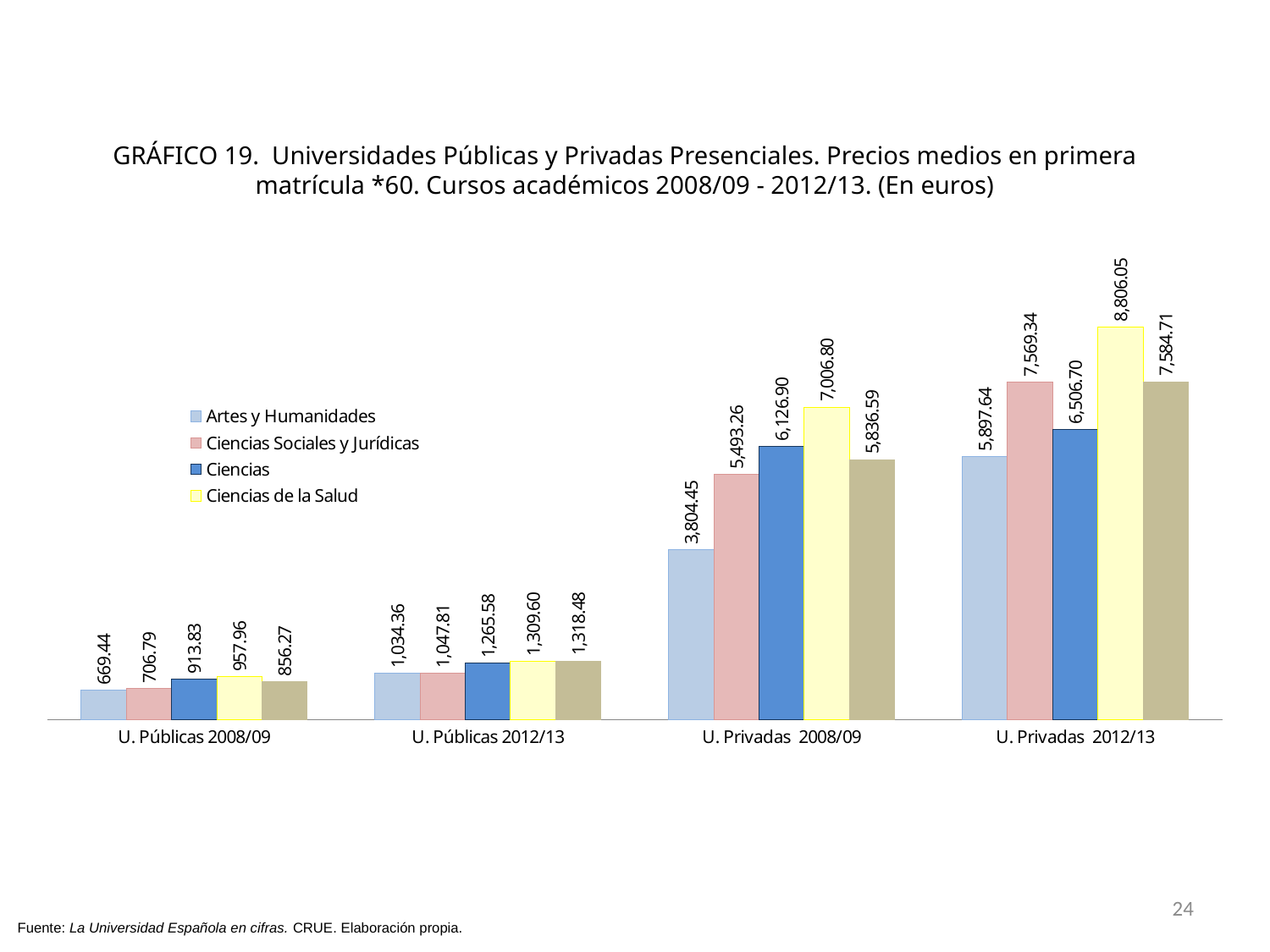
What is the value for Ciencias de la Salud in U. Privadas 2012/13? 8,806.05 What is the value for Artes y Humanidades in U. Públicas 2008/09? 669.44 What kind of chart is shown on the slide? Bar chart What is the difference between the Ciencias de la Salud values for U. Privadas 2012/13 and U. Privadas 2008/09? 1,799.25 What is the value for Ciencias in U. Privadas 2008/09? 6,126.90 Which category has the lowest value for Artes y Humanidades? U. Públicas 2008/09 Which category has the highest value for Ciencias de la Salud? U. Privadas 2012/13 What is the difference between the Artes y Humanidades values for U. Públicas 2012/13 and U. Públicas 2008/09? 364.92 How many categories are shown on the x axis? 4 In U. Privadas 2012/13, which is larger: Ciencias Sociales y Jurídicas or Ciencias? Ciencias Sociales y Jurídicas What is the value for Ciencias Sociales y Jurídicas in U. Públicas 2012/13? 1,047.81 How many series does the legend list? 4